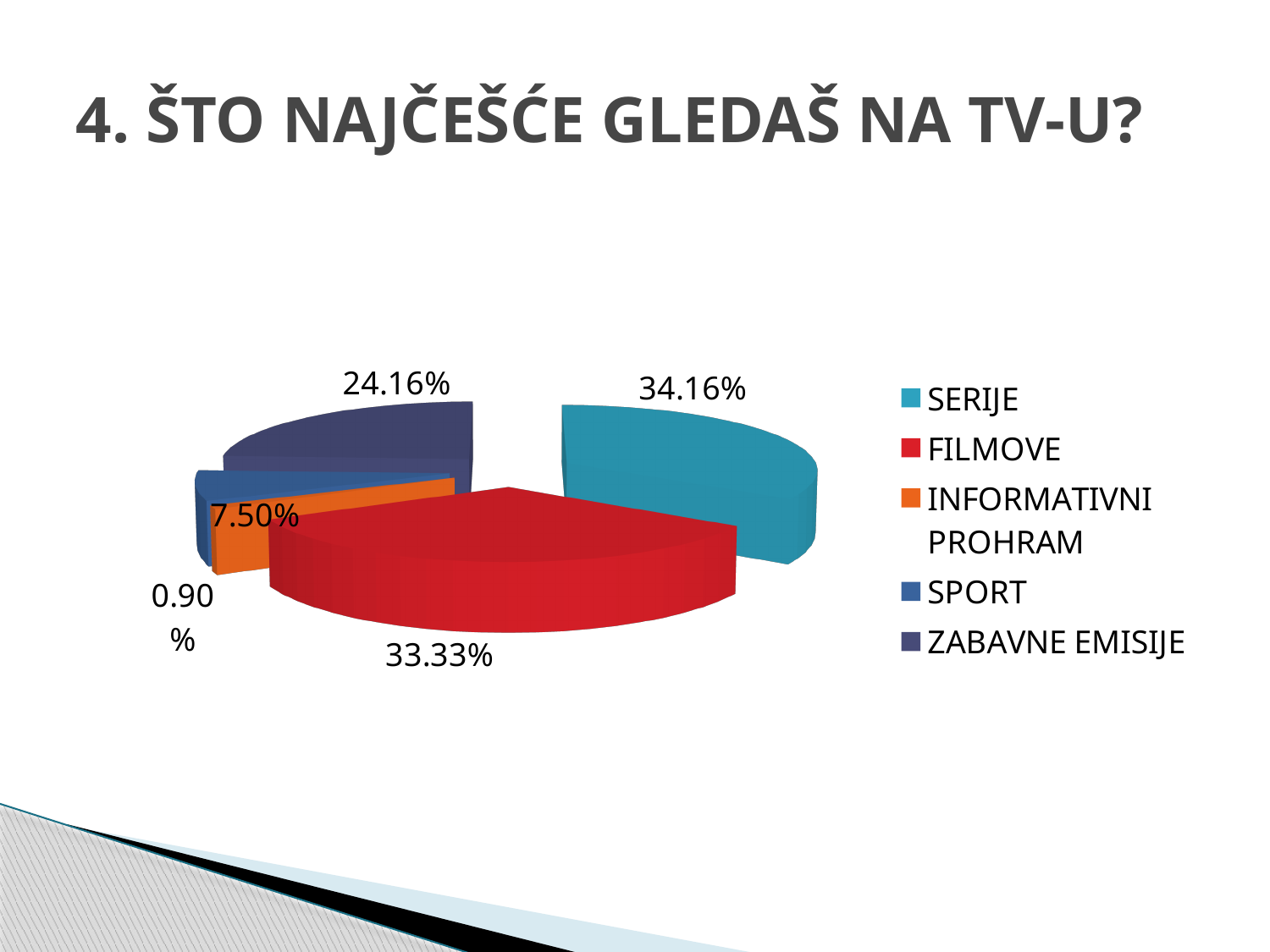
What percentage of the pie is FILMOVE? 33.33% Which category has the smallest share of the pie? INFORMATIVNI PROHRAM What percentage of the pie is ZABAVNE EMISIJE? 24.16% What is the difference in percentage points between SERIJE and FILMOVE? 0.83 What percentage of the pie is INFORMATIVNI PROHRAM? 0.90% Which category has the largest share of the pie? SERIJE What percentage of the pie is SPORT? 7.50% What percentage of the pie is SERIJE? 34.16% What type of chart is shown on the slide? pie chart How many categories does the pie chart have? 5 What colour is the slice for FILMOVE? red Which is larger, the share for ZABAVNE EMISIJE or the share for INFORMATIVNI PROHRAM? ZABAVNE EMISIJE